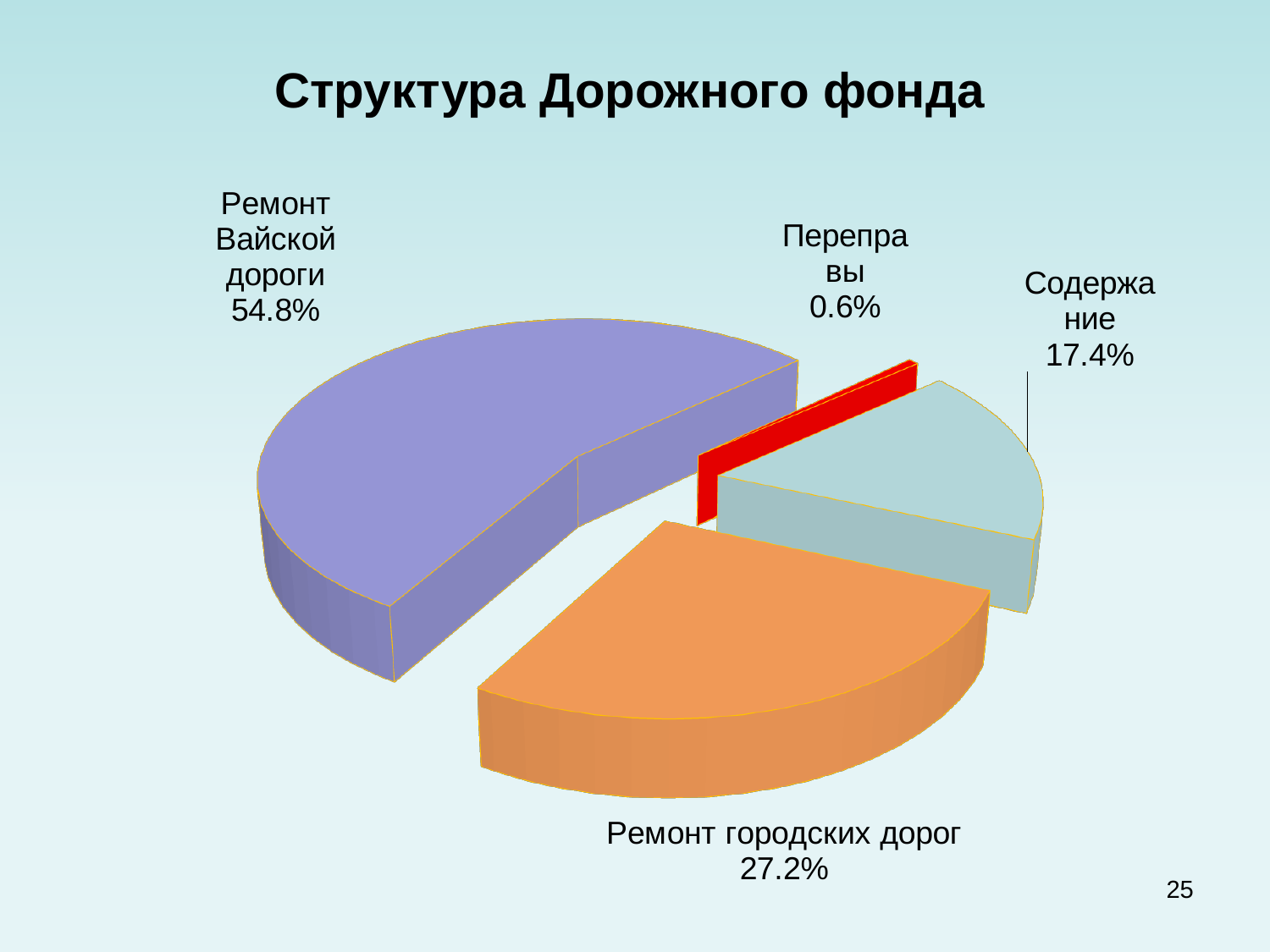
Which category has the smallest share of the pie? Переправы What is the title of the chart? Структура Дорожного фонда What share of the pie does Переправы have? 0.6% What share of the pie does Ремонт Вайской дороги have? 54.8% Which category has the largest share of the pie? Ремонт Вайской дороги What share of the pie does Содержание have? 17.4% What share of the pie does Ремонт городских дорог have? 27.2% Which is larger, the share for Содержание or the share for Ремонт городских дорог? Ремонт городских дорог What is the difference in percentage points between Ремонт Вайской дороги and Ремонт городских дорог? 27.6 What kind of chart is shown on the slide? pie chart How many slices does the pie chart have? 4 What colour is the slice for Переправы? red